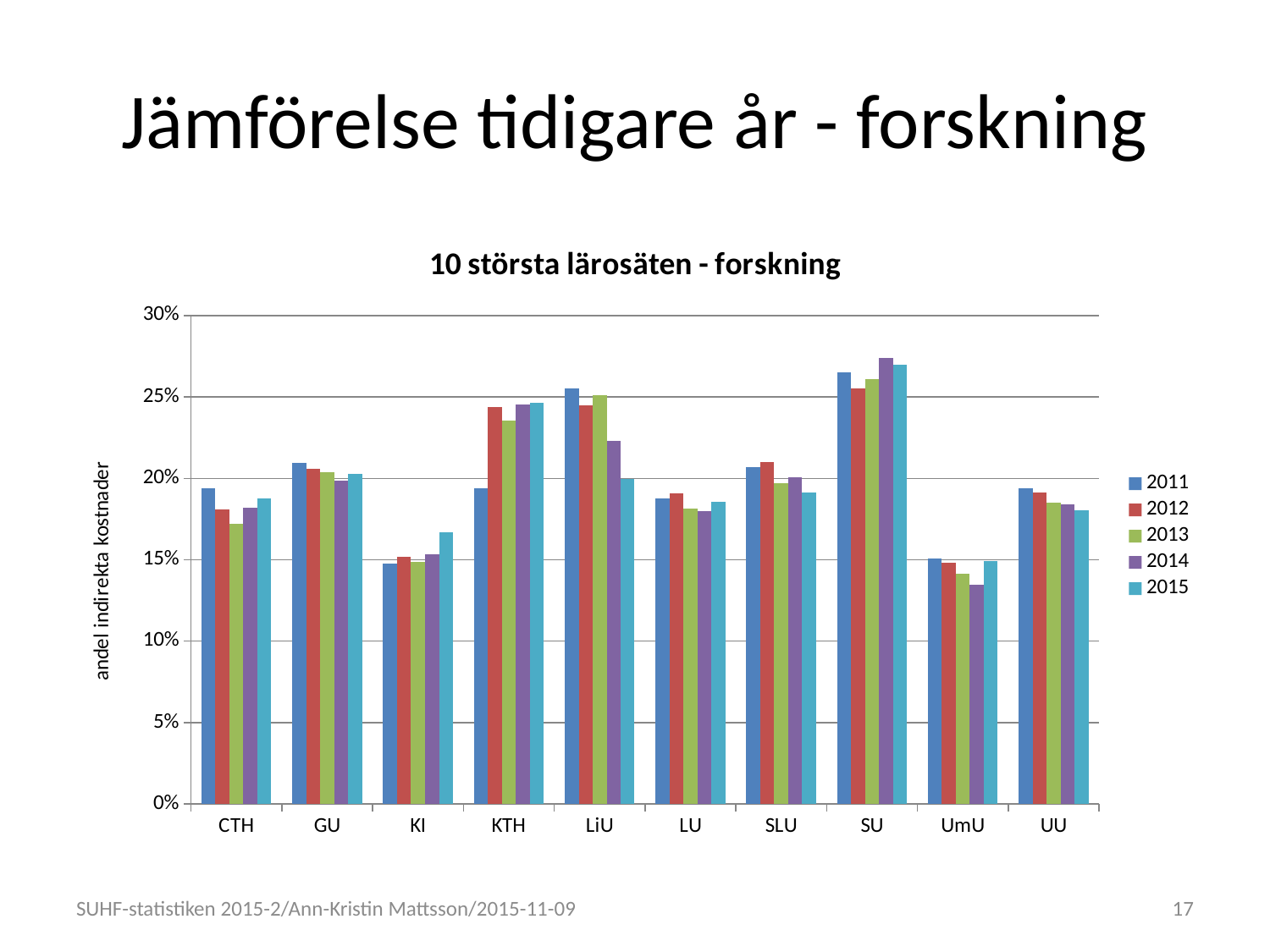
Which institution has the highest value for 2015? SU For KTH, which is larger: the 2011 value or the 2012 value? 2012 For LiU, which is larger: the 2011 value or the 2015 value? 2011 What kind of chart is shown on the slide? bar chart What is the title of the chart? 10 största lärosäten - forskning Is the 2015 value for KI greater or less than 15%? greater What is the label on the vertical axis of the chart? andel indirekta kostnader How many series does the legend of the chart list? 5 How many institutions (categories) are shown on the x axis of the chart? 10 Is the 2014 value for SU greater or less than 25%? greater Is the 2011 value for UmU greater or less than 20%? less Which institution has the lowest value for 2014? UmU